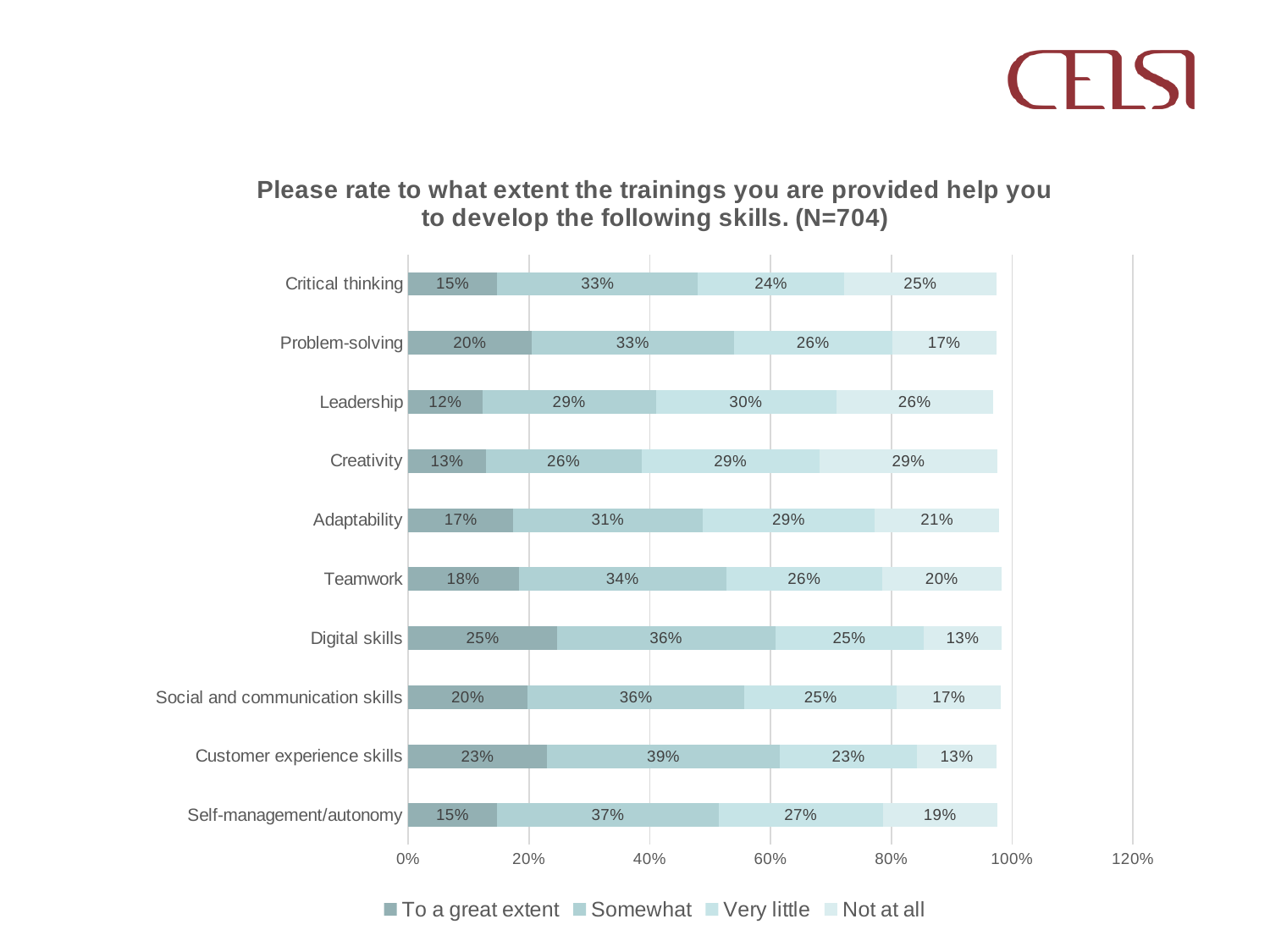
Which has a larger 'Somewhat' value, Teamwork or Creativity? Teamwork Which skill has the highest 'Somewhat' value? Customer experience skills What is the 'Somewhat' value for Customer experience skills? 39% How many skills are listed on the chart? 10 What percentage of respondents said trainings help them develop Digital skills 'To a great extent'? 25% How many series does the legend list? 4 What is the difference in percentage points between the 'To a great extent' values for Digital skills and Leadership? 13 percentage points What is the sample size (N) stated in the chart title? 704 What is the 'Not at all' value for Creativity? 29% Which skill has the lowest 'To a great extent' value? Leadership What kind of chart is shown on the slide? Stacked bar chart Which skill has the highest 'To a great extent' value? Digital skills